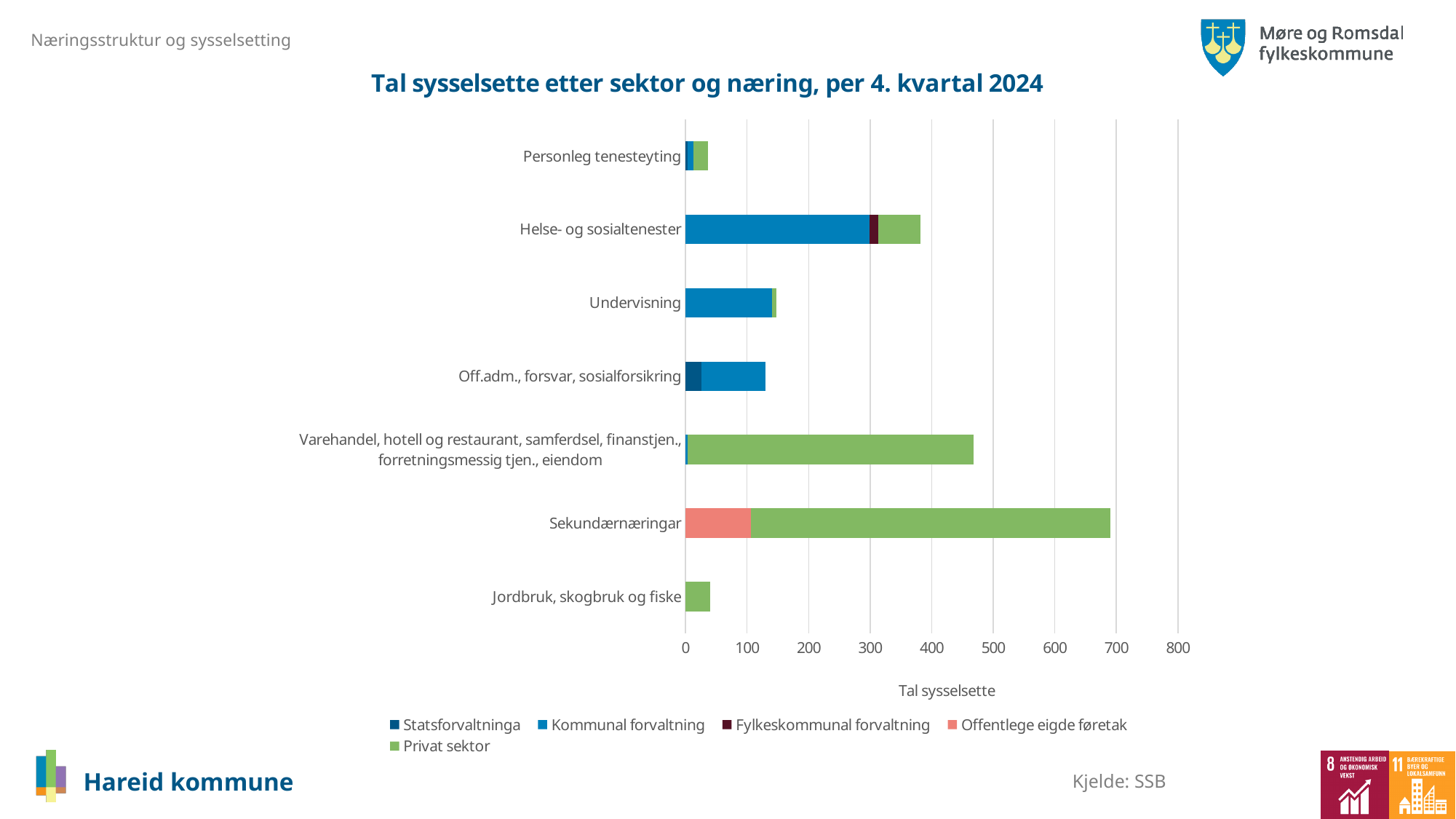
How many categories (næringar) are plotted on the chart? 7 Is the total value for Sekundærnæringar greater or less than 600? greater Which has a larger total: Helse- og sosialtenester or Varehandel, hotell og restaurant, samferdsel, finanstjen., forretningsmessig tjen., eiendom? Varehandel, hotell og restaurant, samferdsel, finanstjen., forretningsmessig tjen., eiendom How many series does the legend list? 5 Is the total value for Helse- og sosialtenester greater or less than 300? greater What kind of chart is shown on the slide? Bar chart Which category has the highest total number of sysselsette? Sekundærnæringar What is the title of the chart? Tal sysselsette etter sektor og næring, per 4. kvartal 2024 Which has a larger total: Helse- og sosialtenester or Undervisning? Helse- og sosialtenester Is the total value for Varehandel, hotell og restaurant, samferdsel, finanstjen., forretningsmessig tjen., eiendom greater or less than 500? less What is the label of the horizontal axis? Tal sysselsette